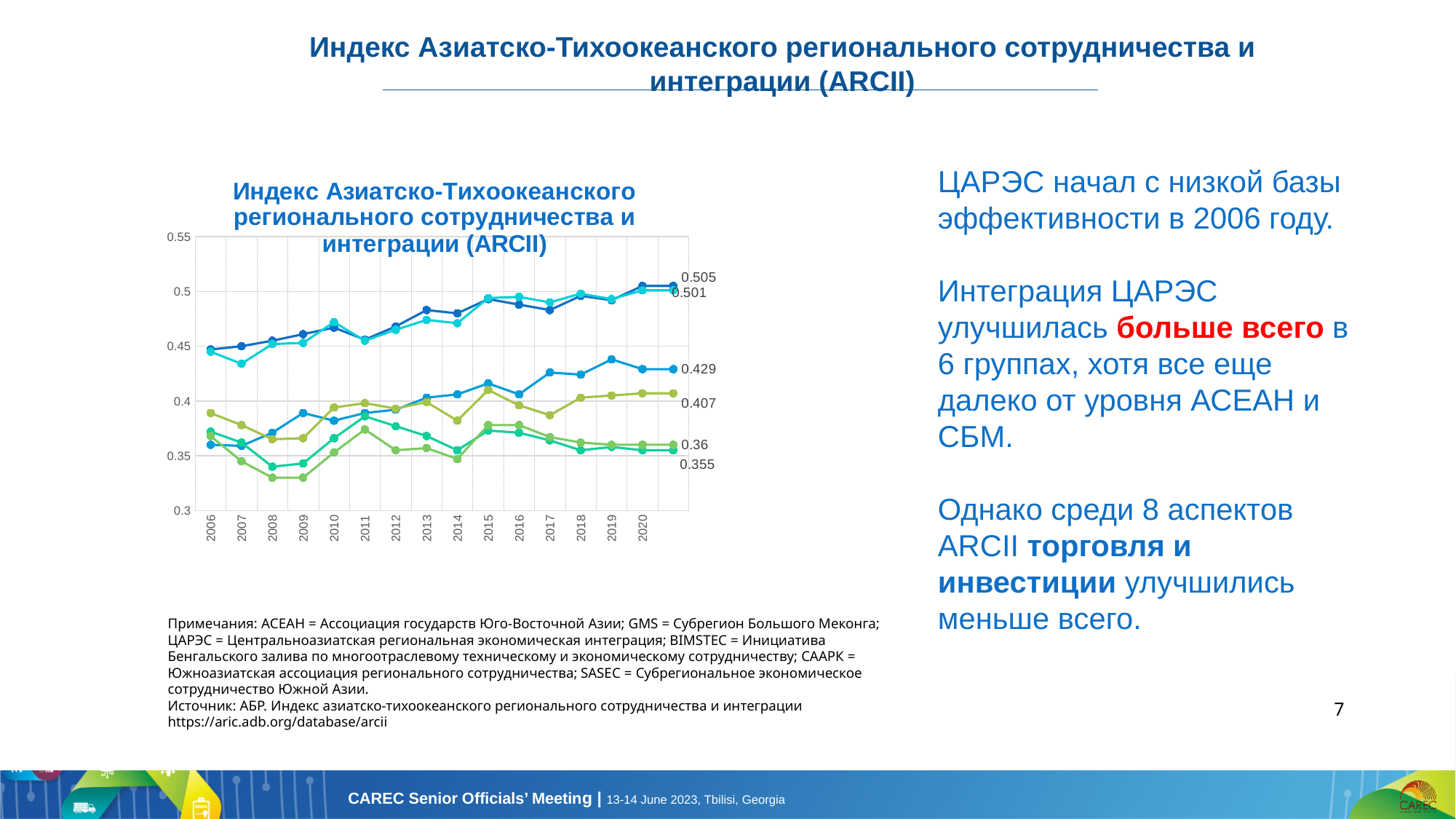
What kind of chart is shown on the slide? line chart How many lines are plotted on the chart? 6 What is the title of the chart? Индекс Азиатско-Тихоокеанского регионального сотрудничества и интеграции (ARCII) What is the highest end-of-series value labelled on the chart? 0.505 Which is larger, the end value labelled 0.429 or the end value labelled 0.407? 0.429 What is the difference between the highest labelled end value (0.505) and the lowest labelled end value (0.355)? 0.15 Is the value of the lowest line in 2008 greater or less than 0.35? less What is the first year labelled on the x axis? 2006 What is the lowest end-of-series value labelled on the chart? 0.355 Is the value of the topmost line in 2010 greater or less than 0.45? greater What is the difference between the end values labelled 0.429 and 0.407? 0.022 Does the topmost line generally rise or fall from 2006 to the end of the series? rise